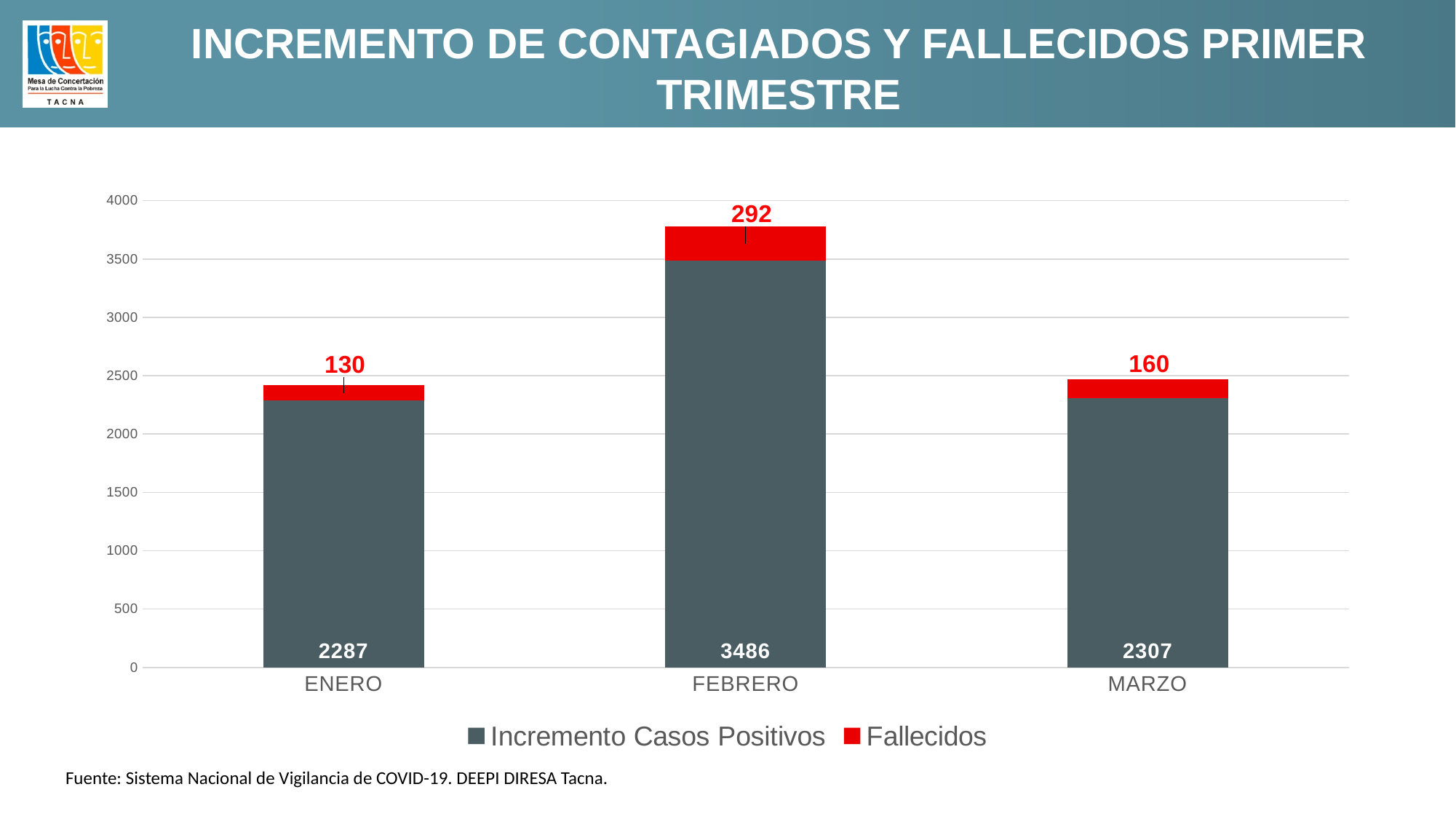
Is the total stacked bar for FEBRERO greater or less than 3500? greater How many series does the legend list? 2 Which month has the highest value for Incremento Casos Positivos? FEBRERO What is the value of Incremento Casos Positivos for FEBRERO? 3486 How many months are shown on the x axis? 3 What is the value of Fallecidos for ENERO? 130 Which month has the lowest value for Fallecidos? ENERO Which is larger, the Incremento Casos Positivos value for ENERO or for MARZO? MARZO What kind of chart is shown on the slide? Stacked bar chart What is the total of the stacked bar for ENERO? 2417 What is the value of Fallecidos for MARZO? 160 What is the difference between the Fallecidos values for FEBRERO and MARZO? 132